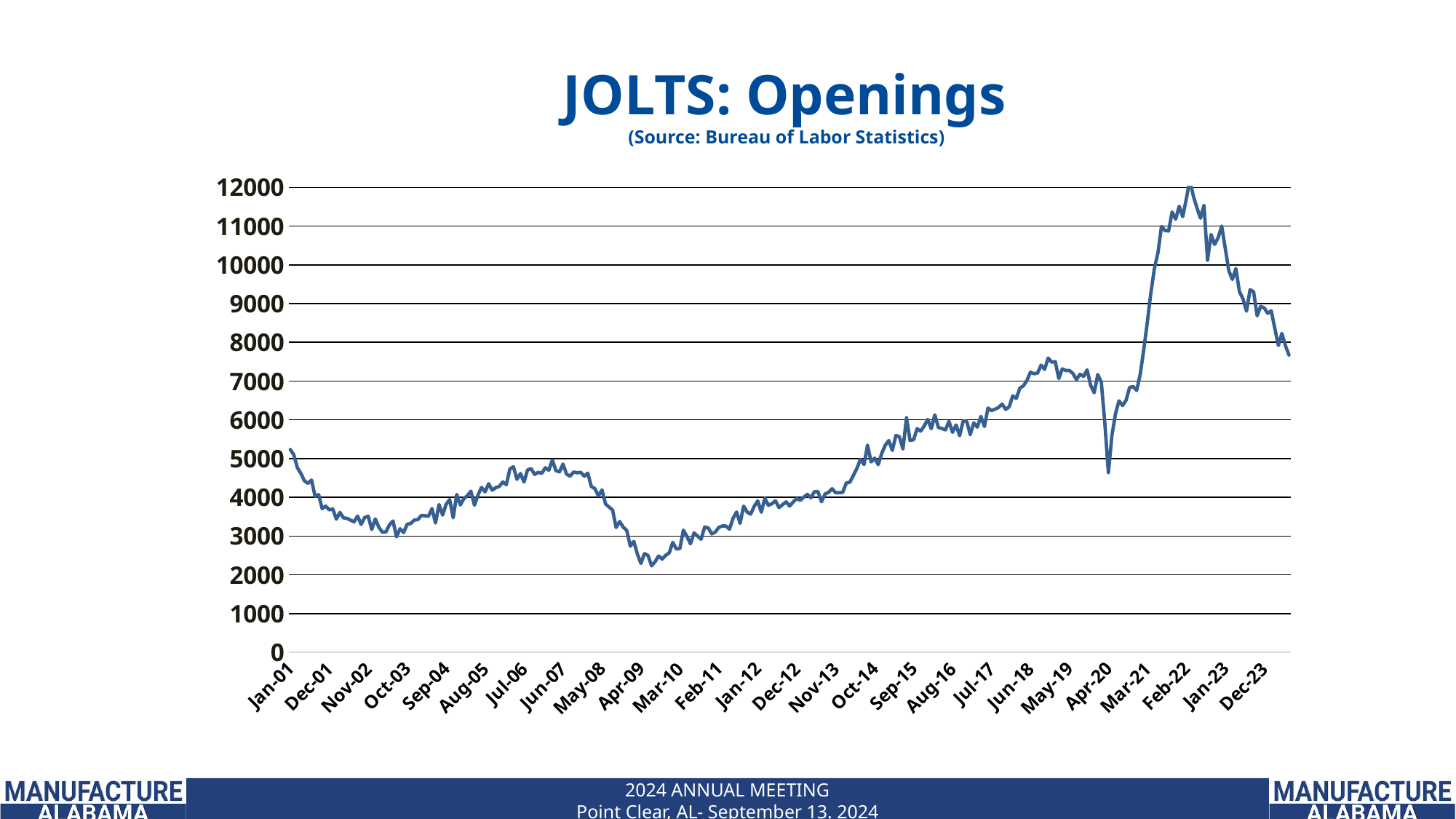
Around which x-axis label does the line reach its highest point? Feb-22 What source is cited for the chart data? Bureau of Labor Statistics What kind of chart is shown on the slide? line chart Around which x-axis label does the line reach its lowest point? Apr-09 Is the value for Apr-09 greater or less than 3000? less Is the value for Dec-23 greater or less than 8000? greater Is the value for Jul-06 greater or less than 4000? greater Do the values rise or fall between Feb-22 and Dec-23? fall What is the title of the chart? JOLTS: Openings